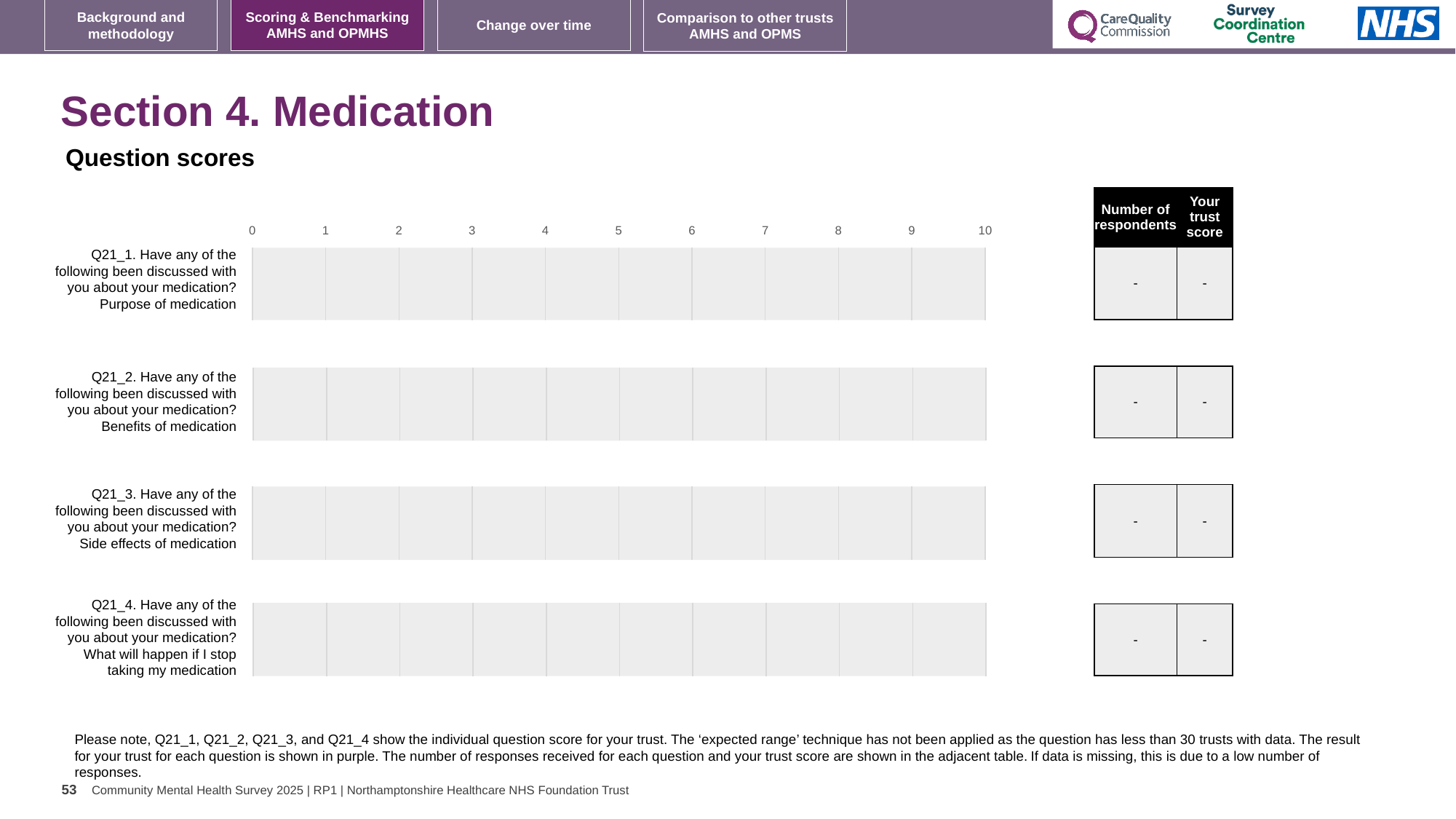
What kind of chart is used on the slide for the question scores? bar chart How many questions (categories) are listed on the chart? 4 What is shown as the trust score for Q21_4 (What will happen if I stop taking my medication) in the adjacent table? - What is shown as the number of respondents for Q21_3 (Side effects of medication) in the adjacent table? - What is shown as the trust score for Q21_1 (Purpose of medication) in the adjacent table? - What is the highest value shown on the chart's x axis? 10 What is the lowest value shown on the chart's x axis? 0 What is shown as the number of respondents for Q21_2 (Benefits of medication) in the adjacent table? -